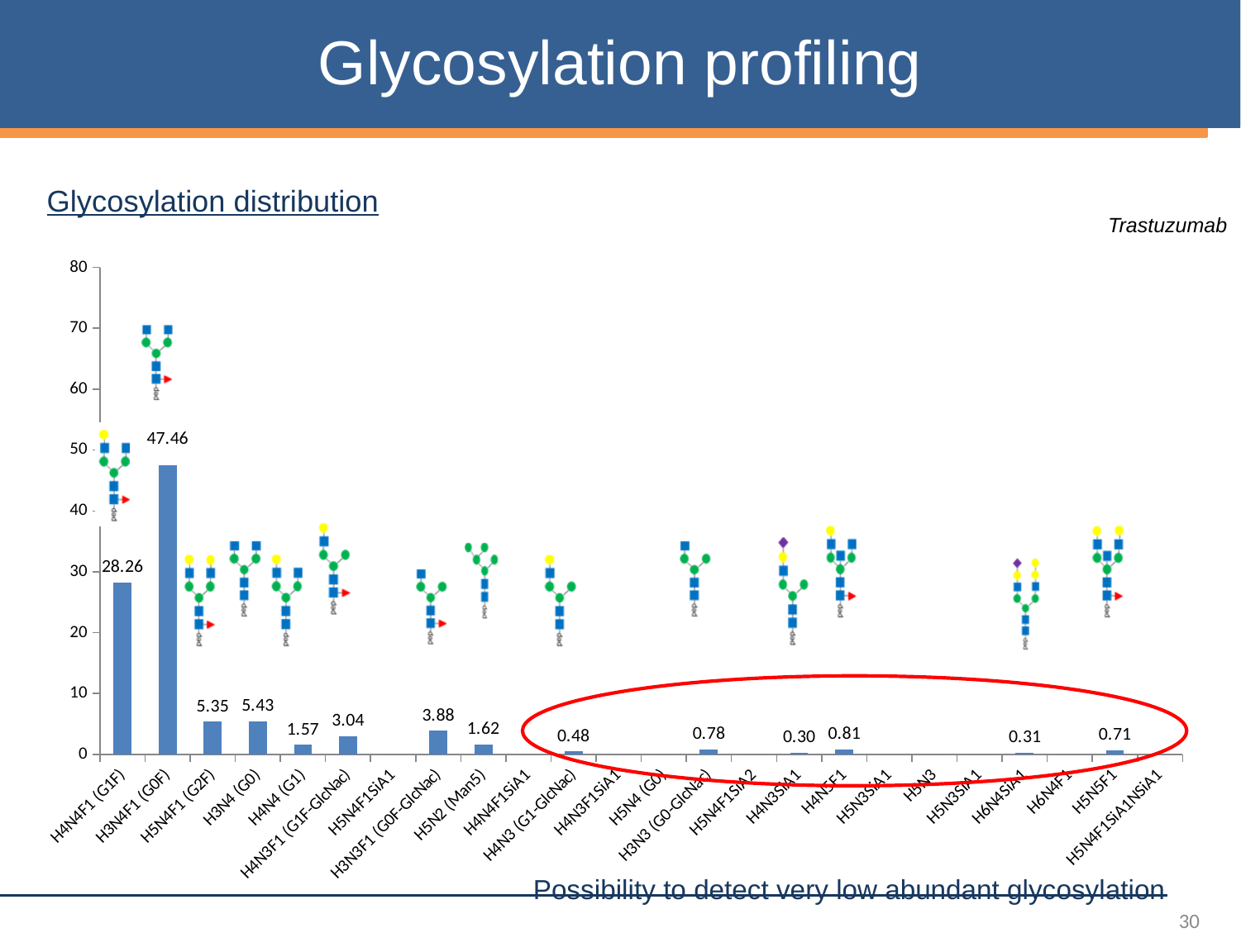
What is the difference between the values for H3N4F1 (G0F) and H4N4F1 (G1F)? 19.20 What is the value for H4N3SiA1? 0.30 Which glycan has the highest value? H3N4F1 (G0F) What is the value for H4N5F1? 0.81 What is the value for H4N4F1 (G1F)? 28.26 What is the value for H3N4F1 (G0F)? 47.46 Is the value for H3N4F1 (G0F) greater or less than 40? greater What kind of chart is shown? Bar chart What is the value for H5N2 (Man5)? 1.62 What is the value for H3N3F1 (G0F-GlcNac)? 3.88 Which is larger, the value for H5N4F1 (G2F) or for H3N4 (G0)? H3N4 (G0) Which antibody is the glycosylation distribution shown for? Trastuzumab